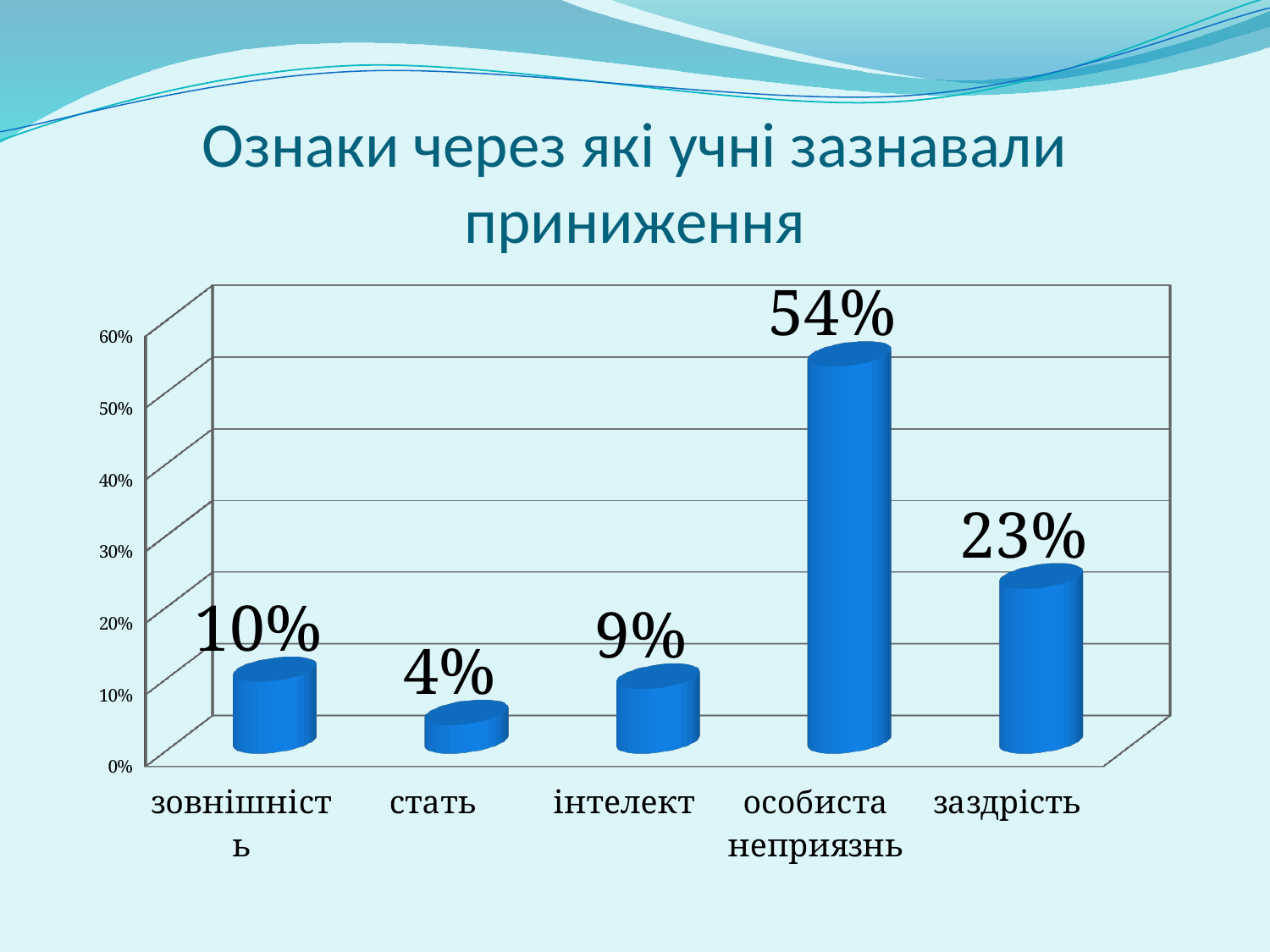
What is the value for заздрість? 23% What is the value for стать? 4% Which category has the lowest value? стать What is the value for інтелект? 9% How many categories are shown in the chart? 5 What is the difference between the values for особиста неприязнь and заздрість? 31% What is the title of the slide? Ознаки через які учні зазнавали приниження What is the value for особиста неприязнь? 54% Which is larger, the value for зовнішність or the value for інтелект? зовнішність What kind of chart is shown on the slide? bar chart Which category has the highest value? особиста неприязнь What is the value for зовнішність? 10%